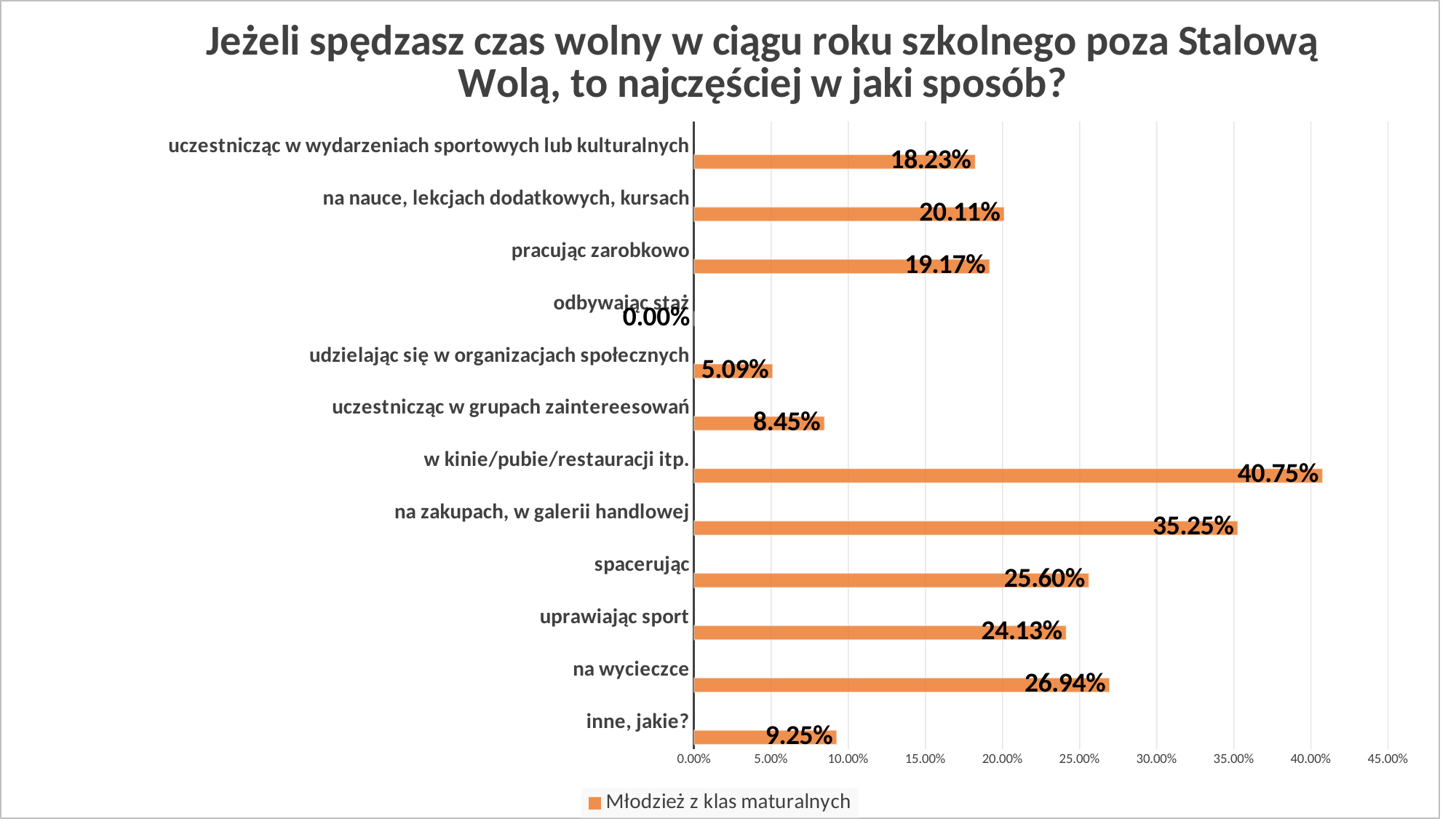
What is the difference between 'w kinie/pubie/restauracji itp.' and 'na zakupach, w galerii handlowej'? 5.50% What type of chart is shown on the slide? bar chart What value is shown for 'odbywając staż'? 0.00% What percentage is shown for 'pracując zarobkowo'? 19.17% Which category has the highest value? w kinie/pubie/restauracji itp. Which category has the lowest value? odbywając staż What percentage is shown for 'w kinie/pubie/restauracji itp.'? 40.75% Which is larger: 'na wycieczce' or 'uprawiając sport'? na wycieczce How many series does the legend list? 1 What is the name of the series shown in the legend? Młodzież z klas maturalnych What value is shown for 'na zakupach, w galerii handlowej'? 35.25% How many categories are shown in the chart? 12